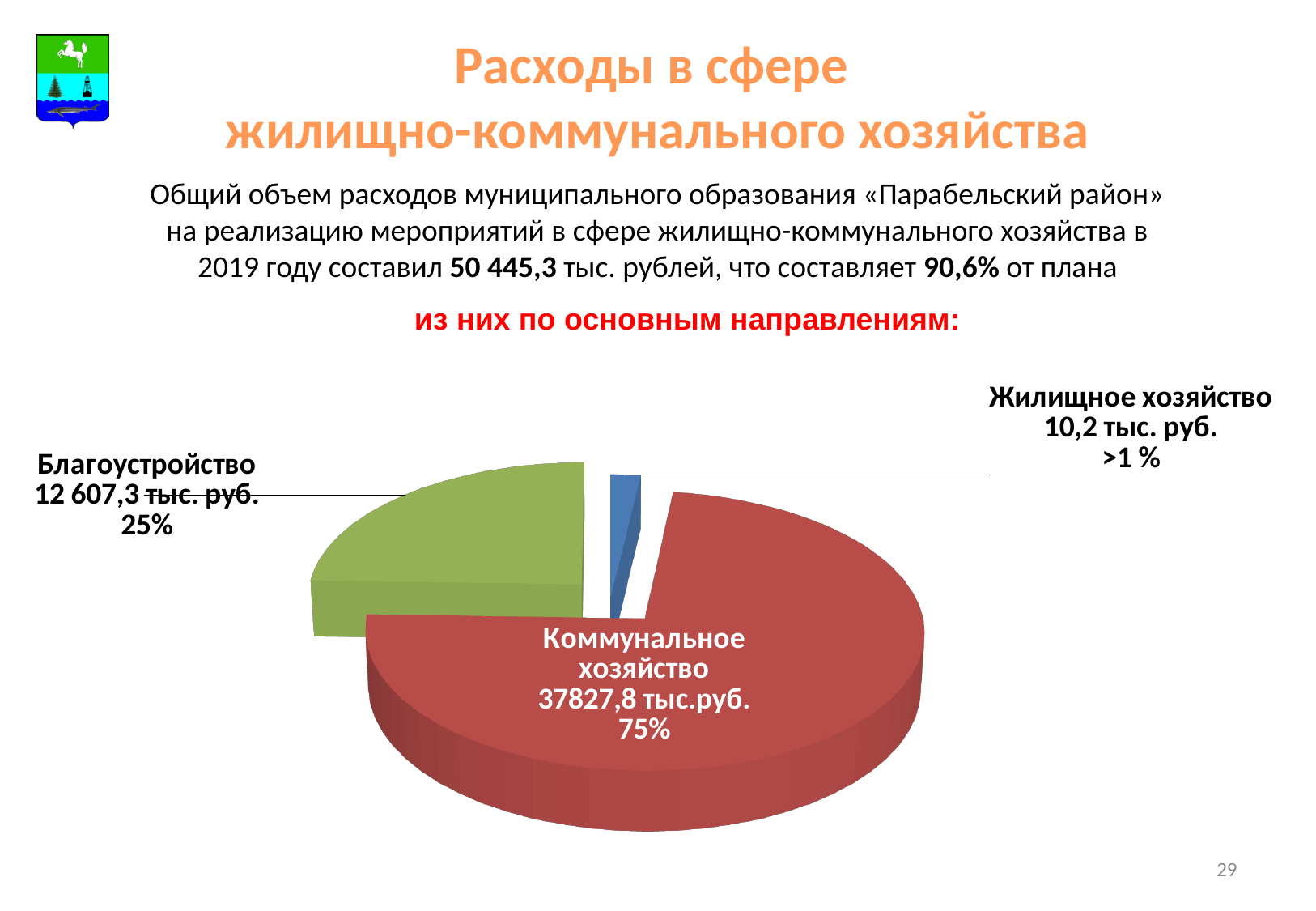
What kind of chart is shown on the slide? pie chart What share of the pie does Коммунальное хозяйство represent? 75% What is the value shown for Коммунальное хозяйство? 37827,8 тыс.руб. What is the value shown for Благоустройство? 12 607,3 тыс. руб. What share label is shown for Жилищное хозяйство? >1 % Which is larger, Благоустройство or Жилищное хозяйство? Благоустройство What share of the pie does Благоустройство represent? 25% What is the value shown for Жилищное хозяйство? 10,2 тыс. руб. How many slices does the pie chart have? 3 Which category has the largest slice of the pie? Коммунальное хозяйство Which category has the smallest slice of the pie? Жилищное хозяйство What colour is the slice for Благоустройство? green